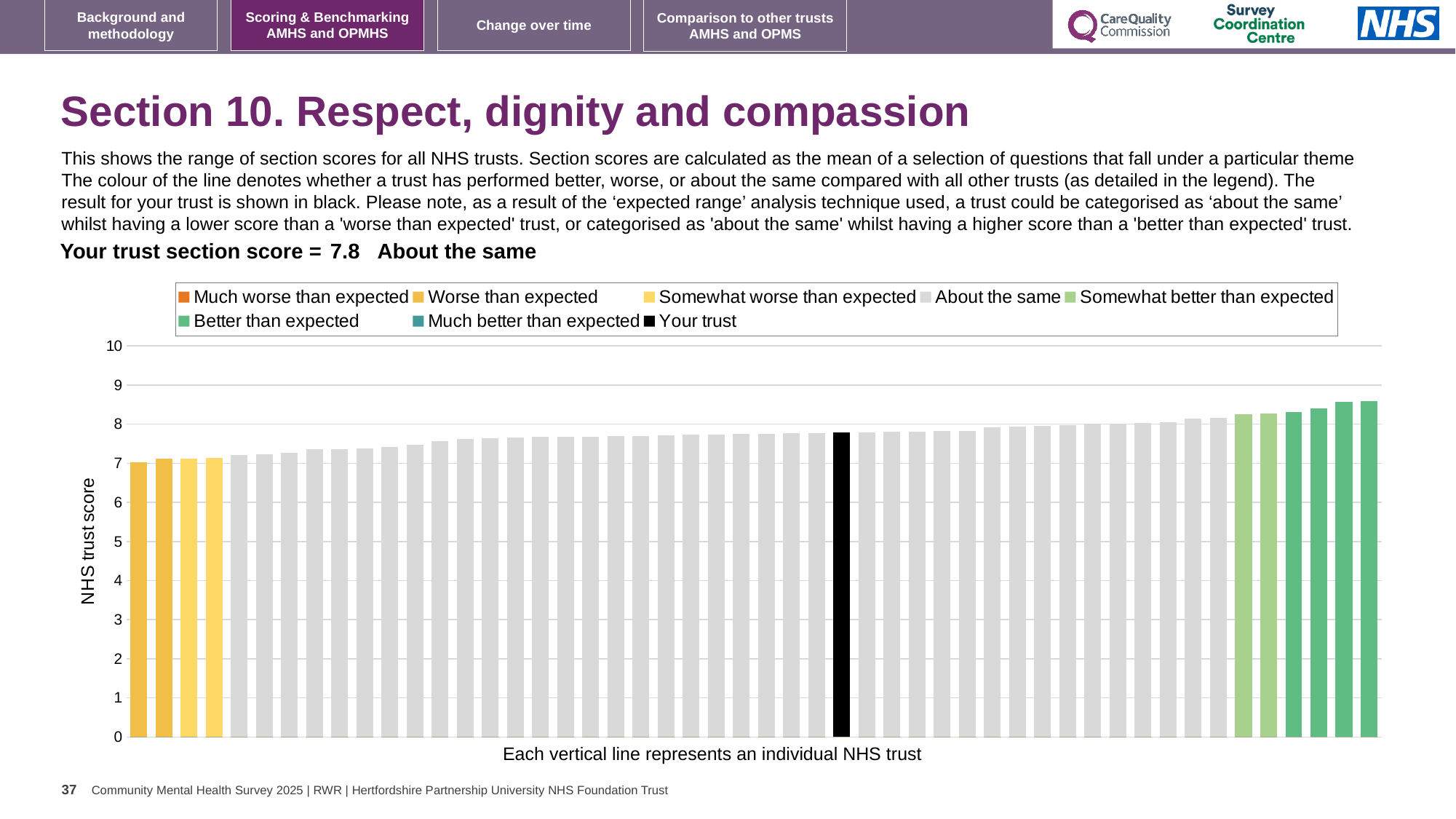
How many entries does the chart legend list? 8 What is the label on the y axis of the chart? NHS trust score How many bars on the chart are black? 1 Is the value for your trust (the black bar) greater or less than 7? greater Is the value for the lowest bar greater or less than 8? less What is the section score for your trust? 7.8 Is the value for the highest bar greater or less than 8? greater What kind of chart is shown on the slide? bar chart Which category does your trust fall into according to the slide? About the same Do the bar values rise or fall from left to right along the x axis? rise